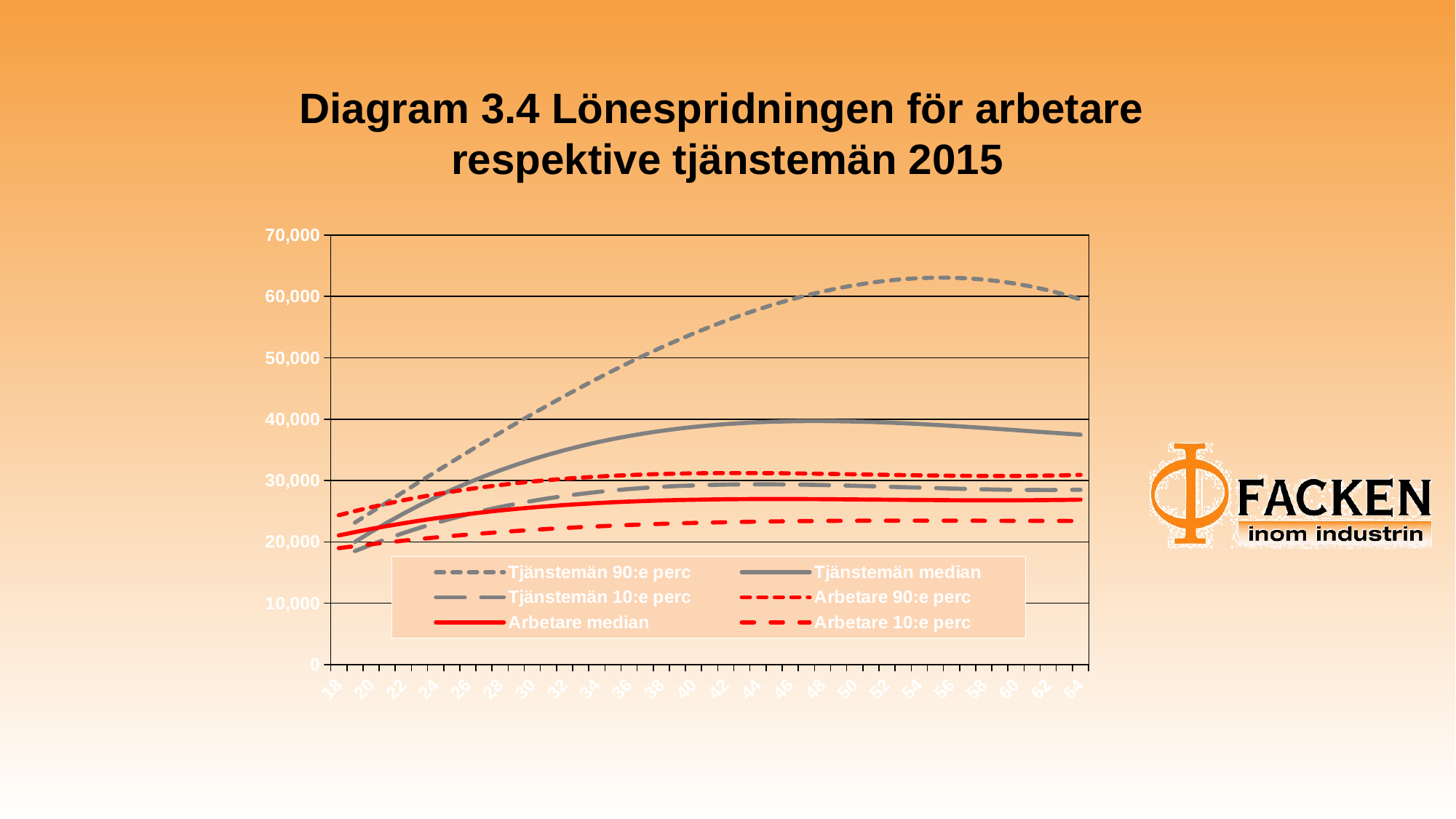
Which series has the highest value at age 56? Tjänstemän 90:e perc How many series does the legend list? 6 Is the value for Arbetare 10:e perc at age 40 greater or less than 20,000? greater What kind of chart is shown on the slide? line chart Which series has the lowest value at age 64? Arbetare 10:e perc Is the value for Tjänstemän 90:e perc at age 56 greater or less than 60,000? greater What is the title of the chart? Diagram 3.4 Lönespridningen för arbetare respektive tjänstemän 2015 Which series is drawn as a solid red line? Arbetare median Does the Tjänstemän 90:e perc line rise or fall from age 18 to age 56? rise Is the value for Tjänstemän median at age 64 greater or less than 40,000? less